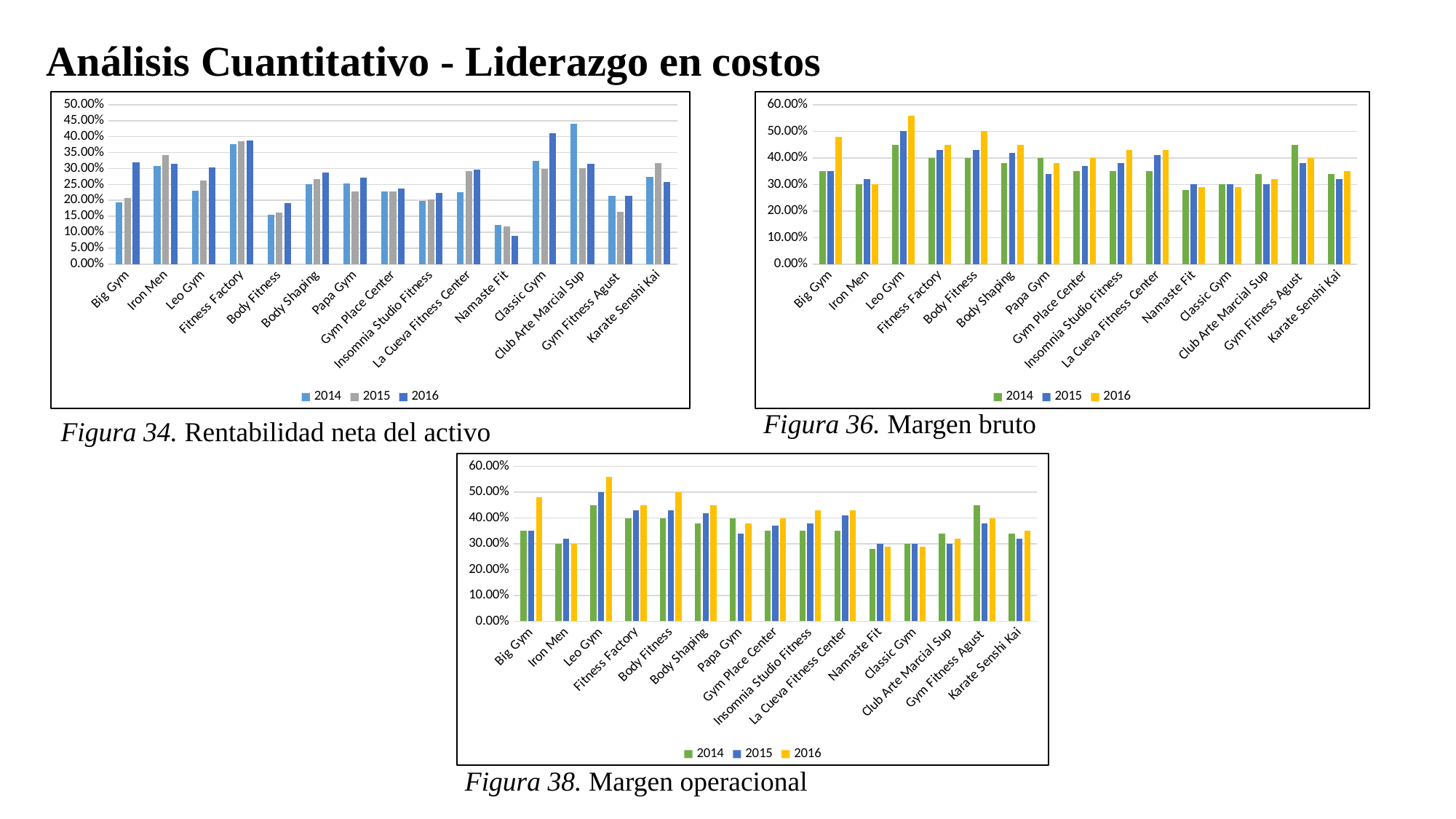
What kind of chart is the Figura 38 chart (Margen operacional)? Bar chart In the Figura 36 chart (Margen bruto), which category has the highest 2016 value? Leo Gym How many categories are shown on the x axis of the Figura 34 chart (Rentabilidad neta del activo)? 15 In the Figura 34 chart (Rentabilidad neta del activo), which is larger: the 2014 value for Club Arte Marcial Sup or the 2014 value for Classic Gym? Club Arte Marcial Sup In the Figura 34 chart (Rentabilidad neta del activo), is the 2014 value for Body Fitness greater or less than 20.00%? less How many series does the legend of the Figura 36 chart (Margen bruto) list? 3 In the Figura 34 chart (Rentabilidad neta del activo), which category has the highest 2014 value? Club Arte Marcial Sup In the Figura 38 chart (Margen operacional), which category has the lowest 2014 value? Namaste Fit In the Figura 38 chart (Margen operacional), is the 2014 value for Gym Fitness Agust greater or less than 40.00%? greater In the Figura 34 chart (Rentabilidad neta del activo), is the 2014 value for Fitness Factory greater or less than 35.00%? greater In the Figura 34 chart (Rentabilidad neta del activo), which category has the lowest 2016 value? Namaste Fit